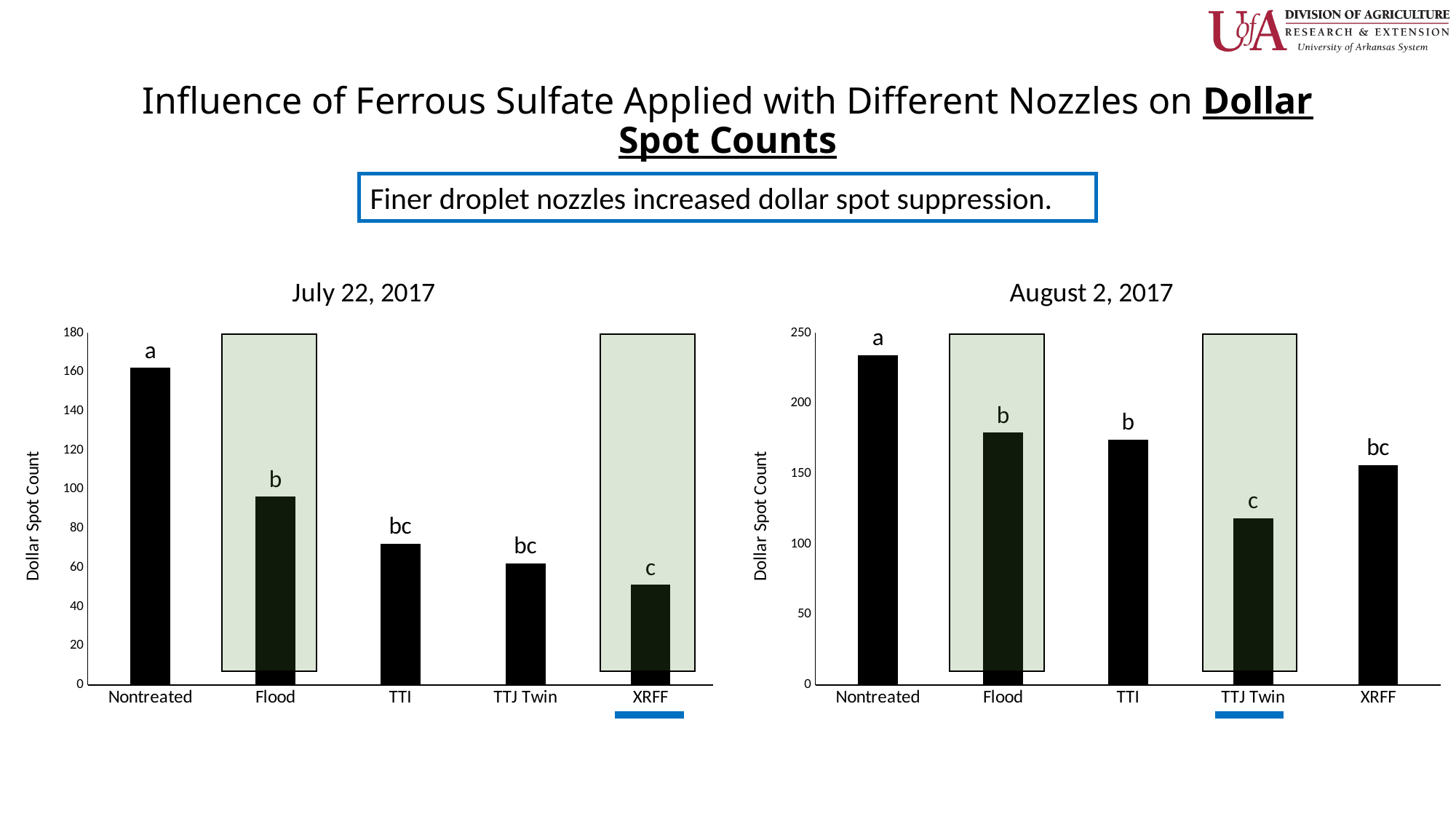
What kind of chart is the July 22, 2017 chart? bar chart In the August 2, 2017 chart, which treatment has the lowest dollar spot count? TTJ Twin In the July 22, 2017 chart, how many treatment categories are shown on the x axis? 5 In the August 2, 2017 chart, which has the larger dollar spot count, Flood or XRFF? Flood In the July 22, 2017 chart, is the value for Flood greater or less than 80? greater In the August 2, 2017 chart, is the value for Nontreated greater or less than 200? greater In the July 22, 2017 chart, which has the larger dollar spot count, TTI or TTJ Twin? TTI In the July 22, 2017 chart, is the value for Nontreated greater or less than 140? greater In the July 22, 2017 chart, which treatment has the lowest dollar spot count? XRFF What is the y-axis title of the August 2, 2017 chart? Dollar Spot Count In the July 22, 2017 chart, which treatment has the highest dollar spot count? Nontreated In the August 2, 2017 chart, which treatment has the highest dollar spot count? Nontreated